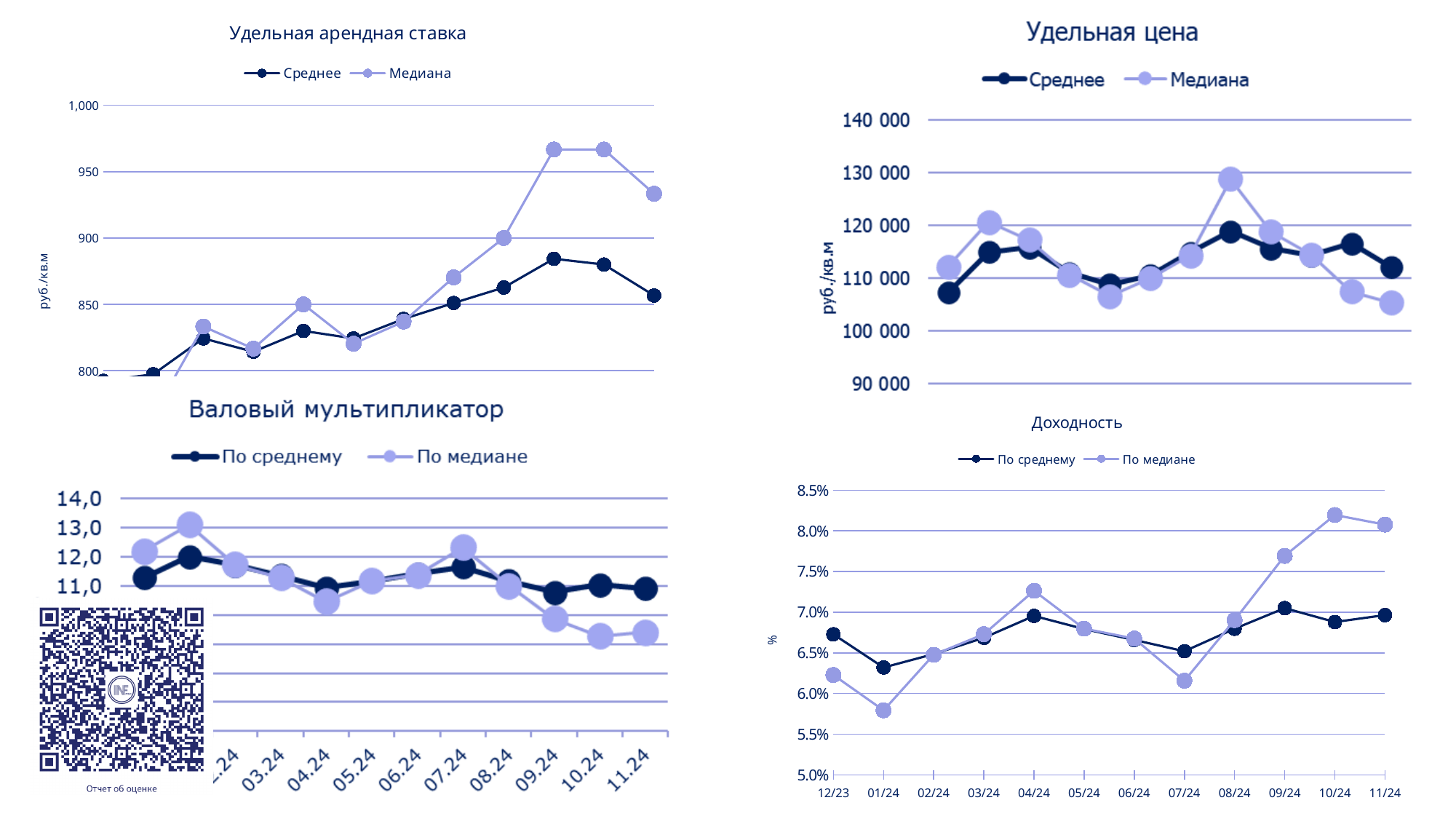
In the "Доходность" chart, which series has the larger value at 10/24, "По среднему" or "По медиане"? По медиане In the "Удельная арендная ставка" chart, is the highest point of the "Медиана" series greater or less than 950? greater In the "Доходность" chart, is the value of "По медиане" for 01/24 greater or less than 6.0%? less How many series does the legend of the "Удельная цена" chart list? 2 What kind of chart is the "Доходность" chart? line chart In the "Валовый мультипликатор" chart, which series has the larger value at 11.24, "По среднему" or "По медиане"? По среднему In the "Валовый мультипликатор" chart, does the "По медиане" series rise or fall from 07.24 to 10.24? fall In the "Доходность" chart, which month has the lowest value for "По медиане"? 01/24 In the "Доходность" chart, is the value of "По среднему" for 07/24 greater or less than 7.0%? less What unit is shown on the y axis of the "Удельная цена" chart? руб./кв.м How many months are shown on the x axis of the "Доходность" chart? 12